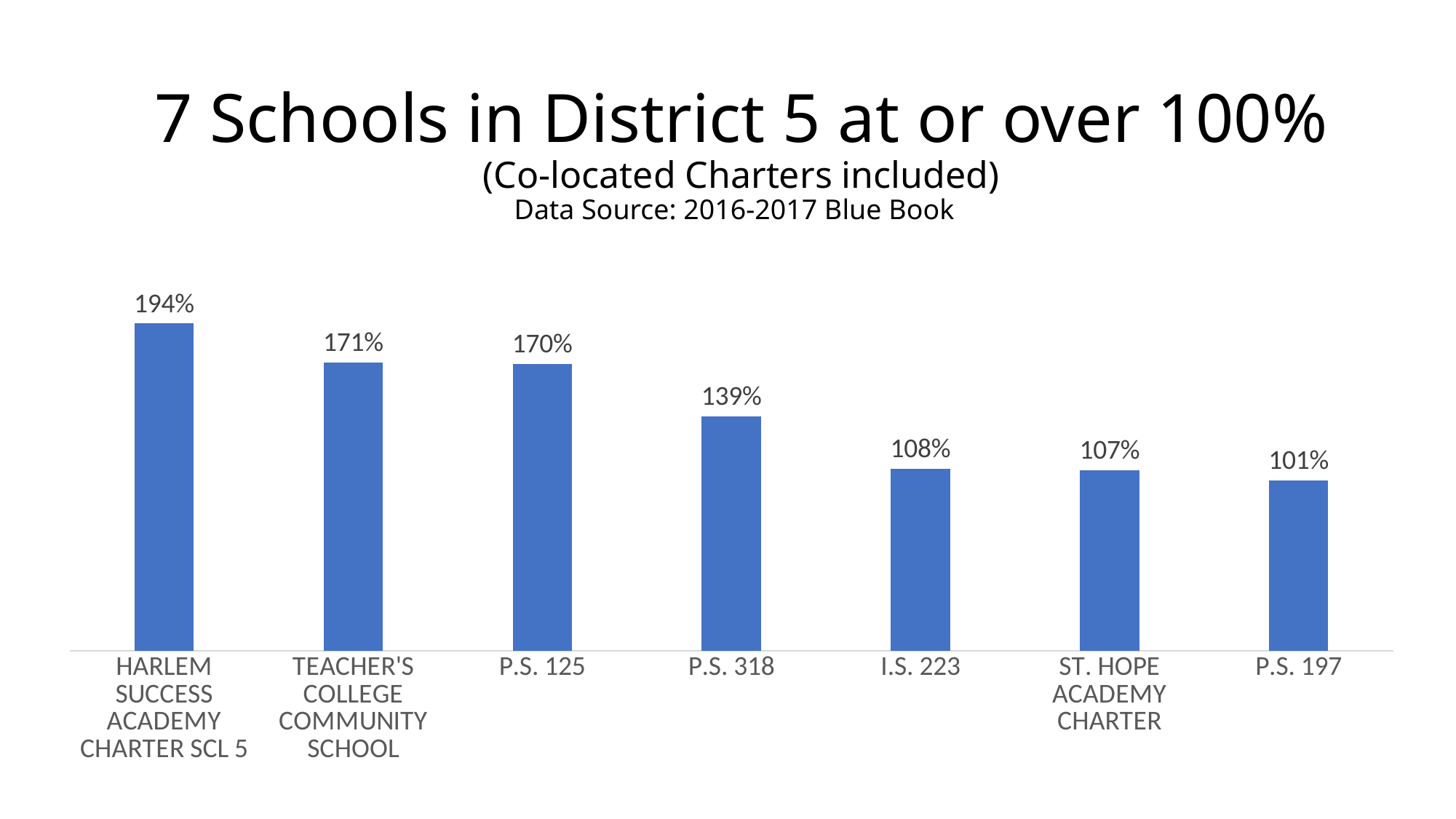
What is the value for Harlem Success Academy Charter Scl 5? 194% Do the values rise or fall from left to right across the chart? Fall What kind of chart is shown on the slide? Bar chart Which school has the lowest value? P.S. 197 What is the value for I.S. 223? 108% What is the difference between the values for Teacher's College Community School and P.S. 125? 1% What is the difference between the values for Harlem Success Academy Charter Scl 5 and P.S. 197? 93% How many schools are shown in the chart? 7 What is the value for St. Hope Academy Charter? 107% Which school has the highest value? Harlem Success Academy Charter Scl 5 Which is larger, the value for P.S. 318 or the value for I.S. 223? P.S. 318 What is the value for P.S. 318? 139%